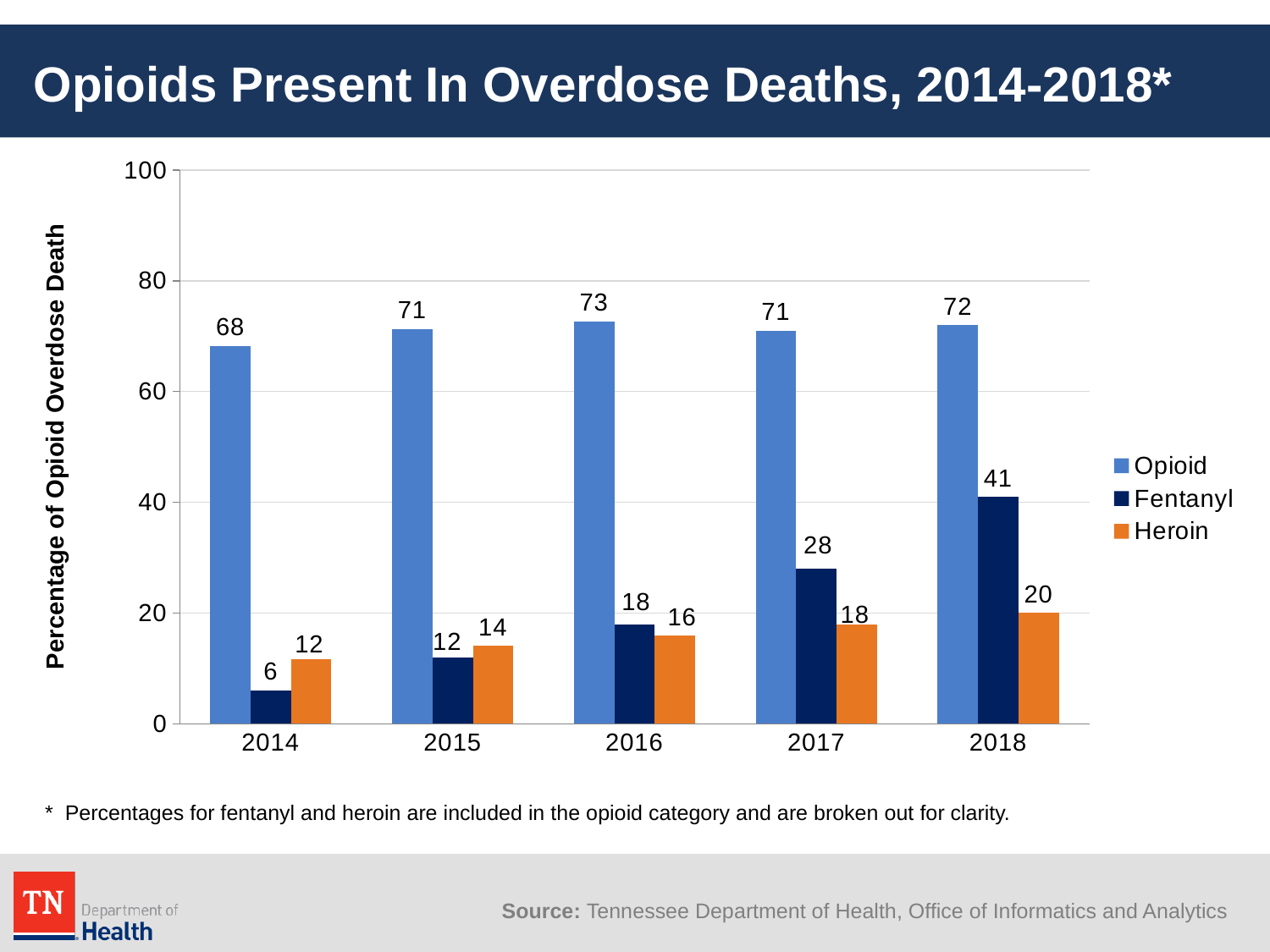
What is the Fentanyl value for 2018? 41 In which year is the Fentanyl value lowest? 2014 What is the Opioid value for 2014? 68 What is the Heroin value for 2016? 16 In which year is the Opioid value highest? 2016 Which is larger in 2015, the Fentanyl value or the Heroin value? Heroin Is the Fentanyl value for 2017 greater or less than 20? greater What is the difference between the Fentanyl values for 2018 and 2017? 13 What kind of chart is shown on the slide? Bar chart Do the Fentanyl values rise or fall from 2014 to 2018? Rise How many years are shown on the x axis? 5 How many series does the legend list? 3